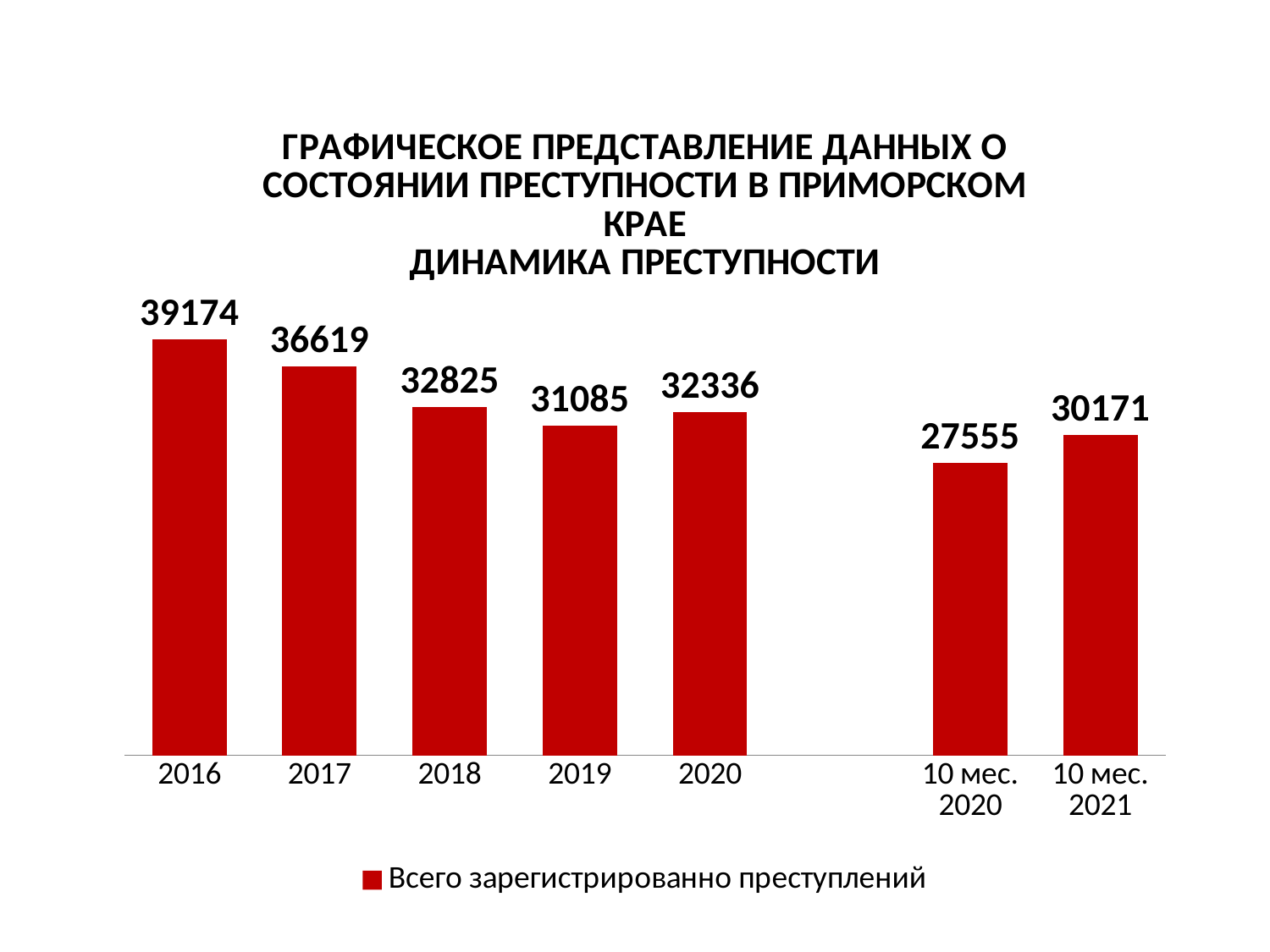
What is the difference between the values for 2016 and 2017? 2555 What is the value for 10 мес. 2021? 30171 Which category has the highest value? 2016 Which is larger, the value for 2019 or the value for 2020? 2020 What is the legend entry for the series? Всего зарегистрированно преступлений What is the difference between the values for 10 мес. 2021 and 10 мес. 2020? 2616 Which category has the lowest value? 10 мес. 2020 How many series does the legend list? 1 How many bars are plotted on the chart? 7 What kind of chart is shown on the slide? bar chart What is the value for 2019? 31085 What is the value for 2016? 39174